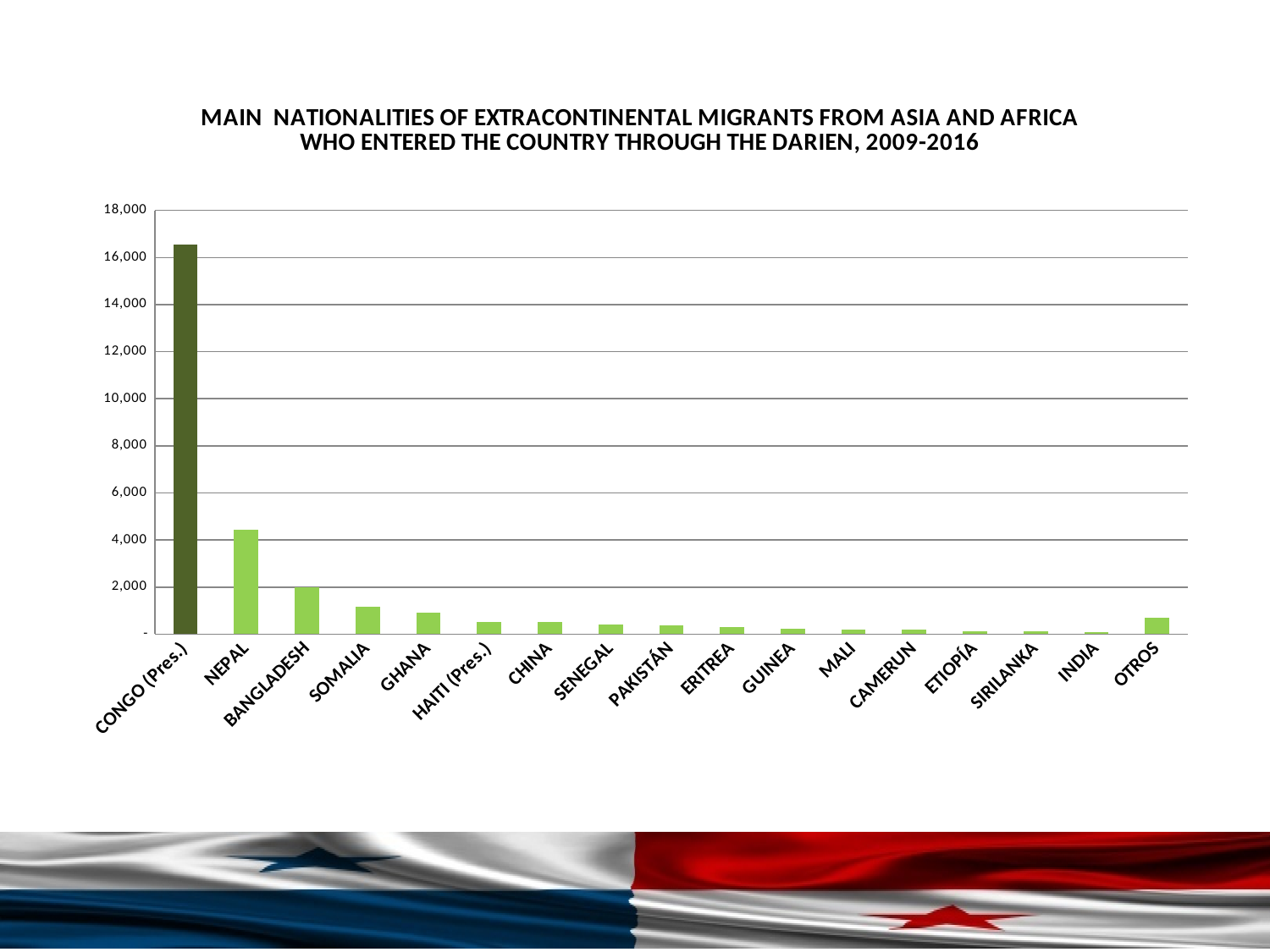
Is the value for NEPAL greater or less than 6,000? less Which is larger, the value for OTROS or the value for INDIA? OTROS Which is larger, the value for NEPAL or the value for BANGLADESH? NEPAL What kind of chart is shown on the slide? Bar chart Is the value for OTROS greater or less than 2,000? less Do the values generally rise or fall along the x axis from CONGO (Pres.) to INDIA? fall Is the value for NEPAL greater or less than 4,000? greater How many nationality categories are plotted on the x axis? 17 Which nationality has the highest number of migrants? CONGO (Pres.) Which bar is shown in a darker green colour than the others? CONGO (Pres.)